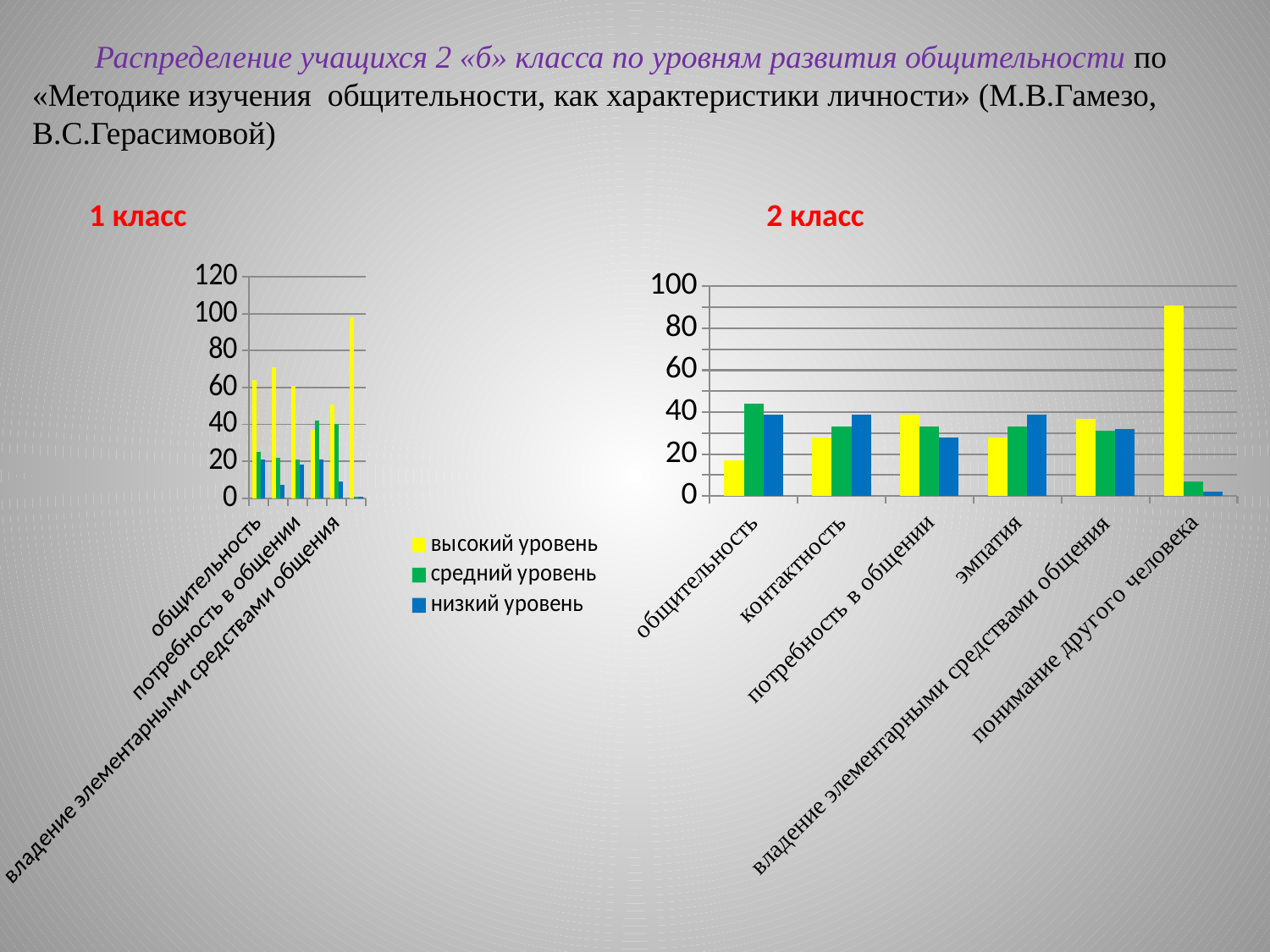
How many charts are on the slide? 2 In the '2 класс' chart, which category has the lowest value for 'высокий уровень'? общительность What kind of chart is the '2 класс' chart? bar chart In the '2 класс' chart, how many categories are shown on the x axis? 6 In the '1 класс' chart, is the 'высокий уровень' value for 'общительность' greater or less than 40? greater In the '2 класс' chart, which category has the highest value for 'высокий уровень'? понимание другого человека How many series does the legend list? 3 In the '2 класс' chart, is the 'средний уровень' value for 'понимание другого человека' greater or less than 20? less In the '2 класс' chart, for 'общительность', which is larger: 'высокий уровень' or 'средний уровень'? средний уровень In the '2 класс' chart, is the 'высокий уровень' value for 'понимание другого человека' greater or less than 80? greater Which colour represents 'низкий уровень' in the legend? blue